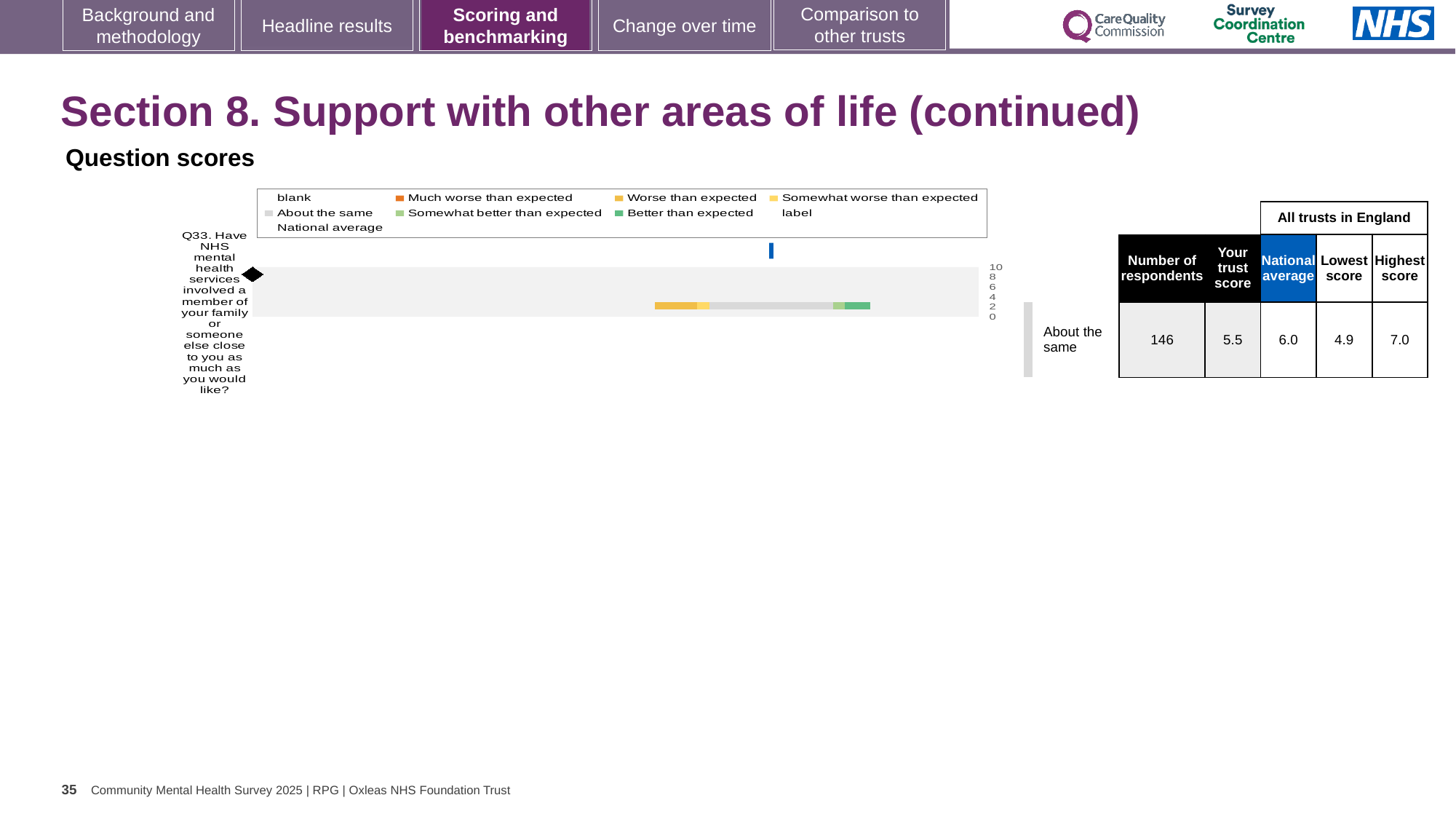
What is the lowest score among all trusts in England for Q33? 4.9 How many questions are plotted in the Question scores chart? 1 Which is larger for Q33, the trust's score or the national average? national average How many entries does the legend of the Question scores chart list? 9 What is the difference between the national average and the trust's score for Q33? 0.5 How many respondents answered Q33? 146 What is the trust's score for Q33 shown alongside the chart? 5.5 Which benchmark category is the trust's Q33 score placed in? About the same What is the highest score among all trusts in England for Q33? 7.0 What kind of chart is used to show the question score for Q33? bar chart What is the difference between the highest and lowest scores among all trusts in England for Q33? 2.1 What is the national average score for Q33? 6.0